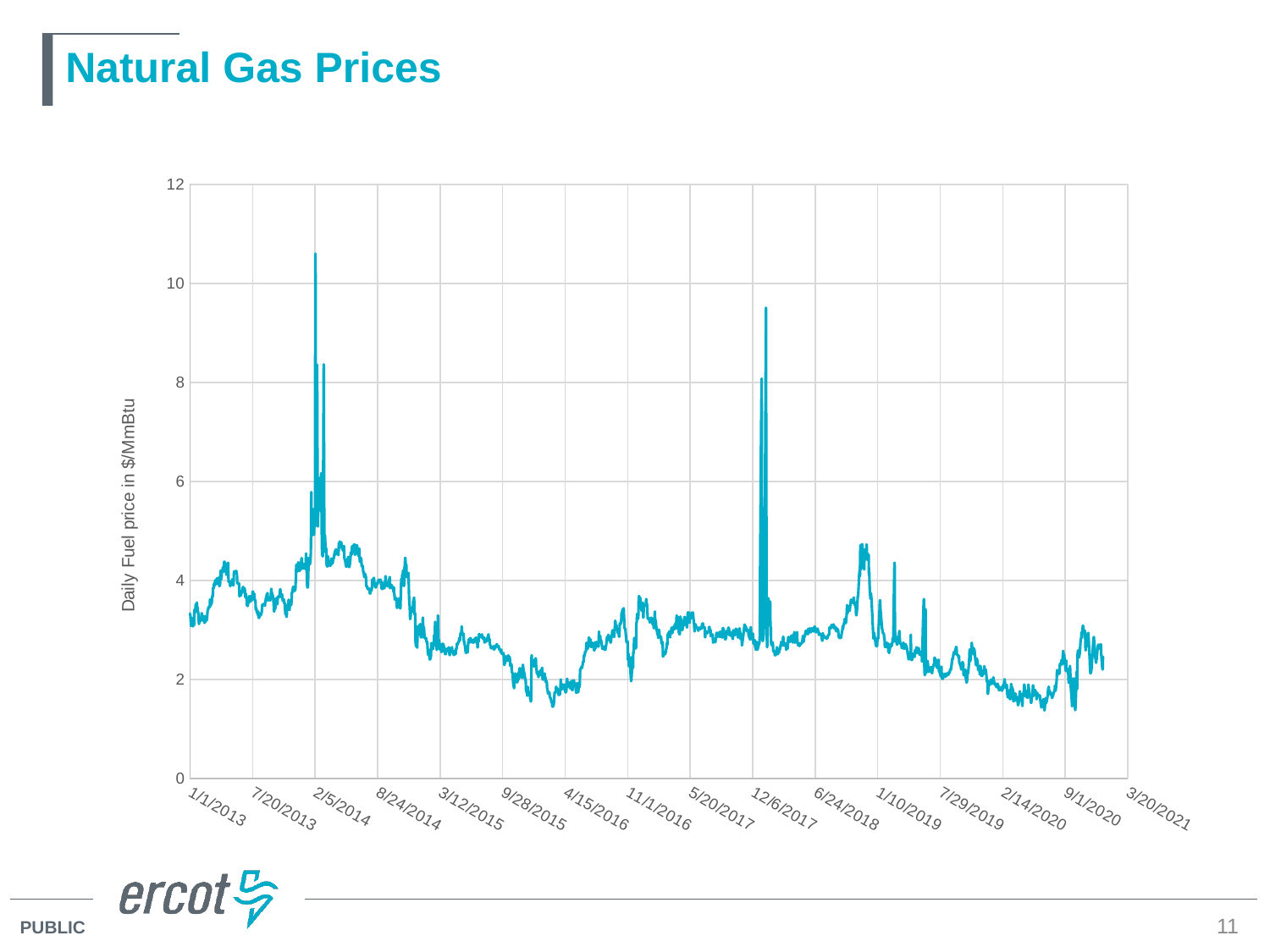
What kind of chart is shown on the slide? line chart Is the price at the start of the series, 1/1/2013, greater or less than 4? less Is the spike in the price near 12/6/2017 greater or less than 10? less How many lines (series) are plotted on the chart? 1 Is the spike in the price near 12/6/2017 greater or less than 8? greater What is the label on the vertical axis of the chart? Daily Fuel price in $/MmBtu What is the title of the chart on the slide? Natural Gas Prices Overall, does the price rise or fall from 2013 to 2020? fall What is the highest value shown on the vertical axis? 12 Which spike is higher: the one near 2/5/2014 or the one near 12/6/2017? the one near 2/5/2014